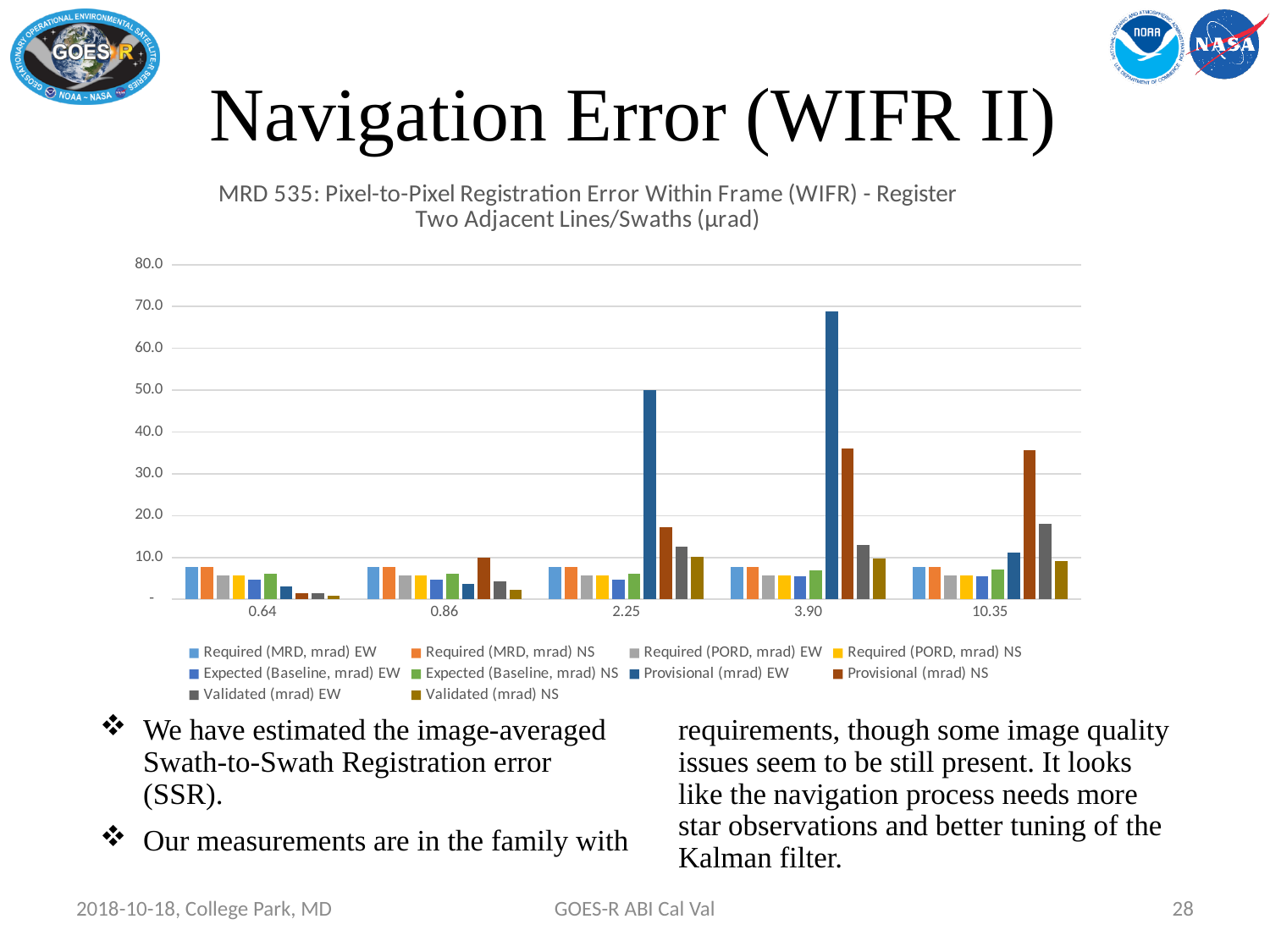
Is the value for Required (MRD, mrad) EW at category 0.64 greater or less than 10? less Which category on the x axis contains the tallest bar in the chart? 3.90 Which series has the tallest bar in the chart? Provisional (mrad) EW What is the highest value shown on the chart's y axis? 80.0 What kind of chart is shown on the slide? bar chart Is the value for Provisional (mrad) EW at category 3.90 greater or less than 60? greater How many series does the chart's legend list? 10 Is the value for Validated (mrad) EW at category 10.35 greater or less than 20? less How many categories are shown along the x axis of the chart? 5 At category 2.25, which is larger: Provisional (mrad) NS or Validated (mrad) EW? Provisional (mrad) NS Which is larger: Provisional (mrad) EW at category 3.90 or Provisional (mrad) EW at category 2.25? Provisional (mrad) EW at 3.90